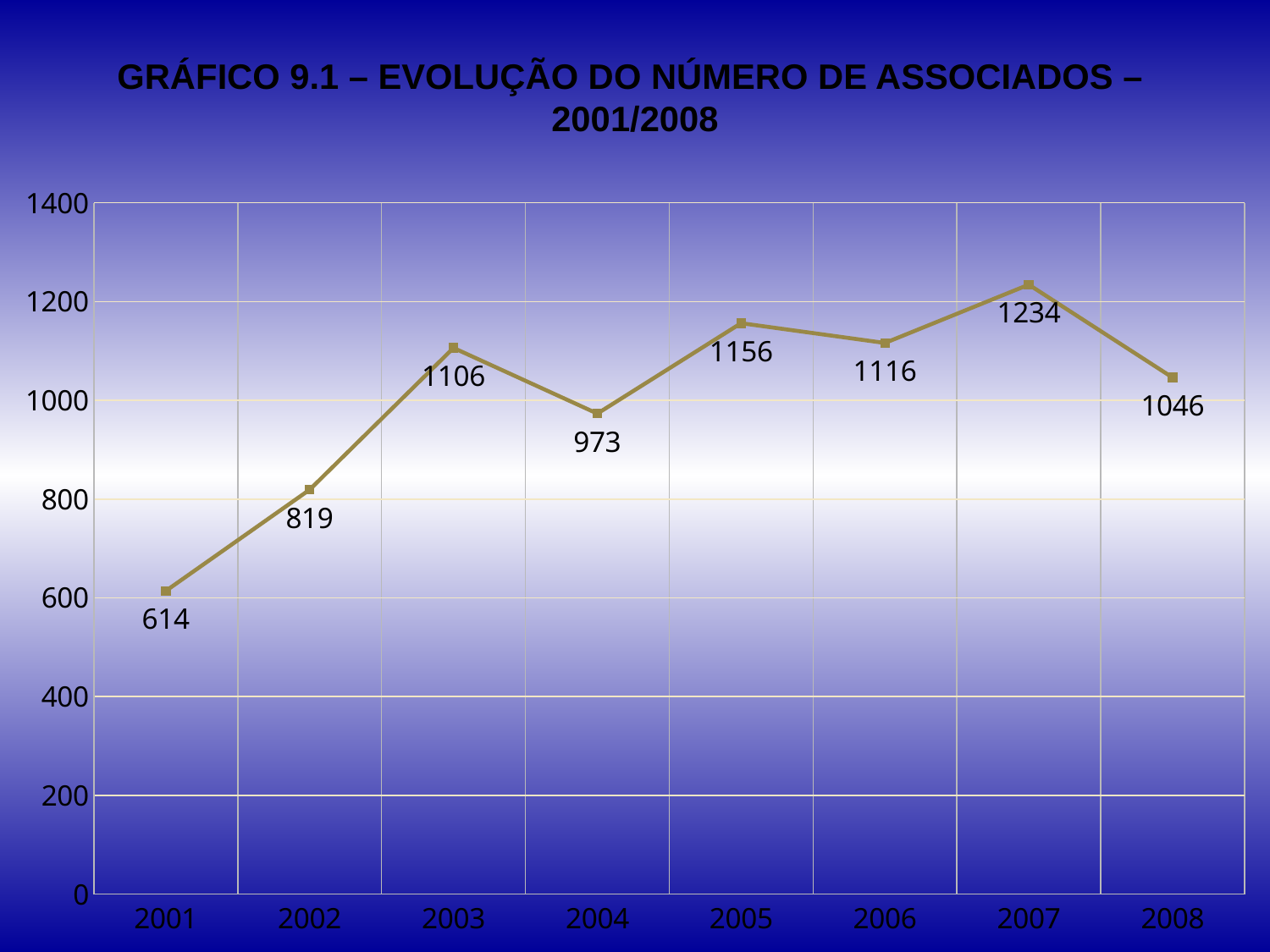
Which year has the highest value? 2007 How many years are plotted on the chart? 8 What kind of chart is shown on the slide? line chart Does the value rise or fall from 2007 to 2008? fall What is the value plotted for 2008? 1046 Which year has the lowest value? 2001 What is the value plotted for 2004? 973 What is the difference between the values for 2003 and 2004? 133 What is the number of associados in 2001? 614 What is the difference between the values for 2007 and 2001? 620 Is the value for 2002 greater or less than 1000? less Which year has a larger value, 2005 or 2006? 2005